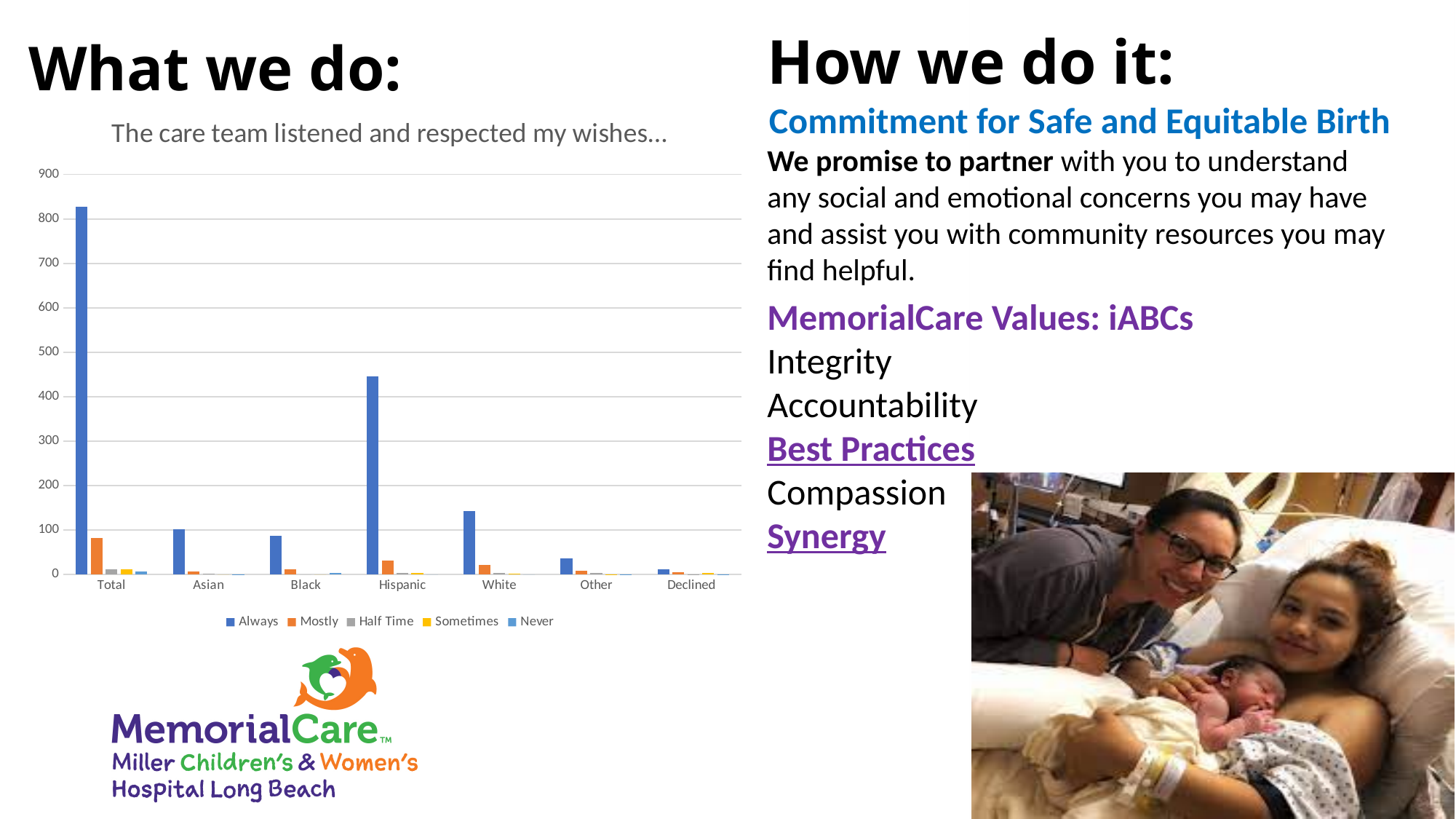
Which has the larger "Always" value, Hispanic or White? Hispanic How many categories are shown along the x axis of the chart? 7 What is the title of the chart on the slide? The care team listened and respected my wishes... What kind of chart is shown under "What we do:"? bar chart Which category has the lowest "Always" value? Declined How many series does the chart's legend list? 5 Is the "Always" value for Total greater or less than 800? greater Is the "Always" value for White greater or less than 100? greater Excluding Total, which category has the highest "Always" value? Hispanic Is the "Always" value for Hispanic greater or less than 500? less Which category has the tallest "Always" bar? Total